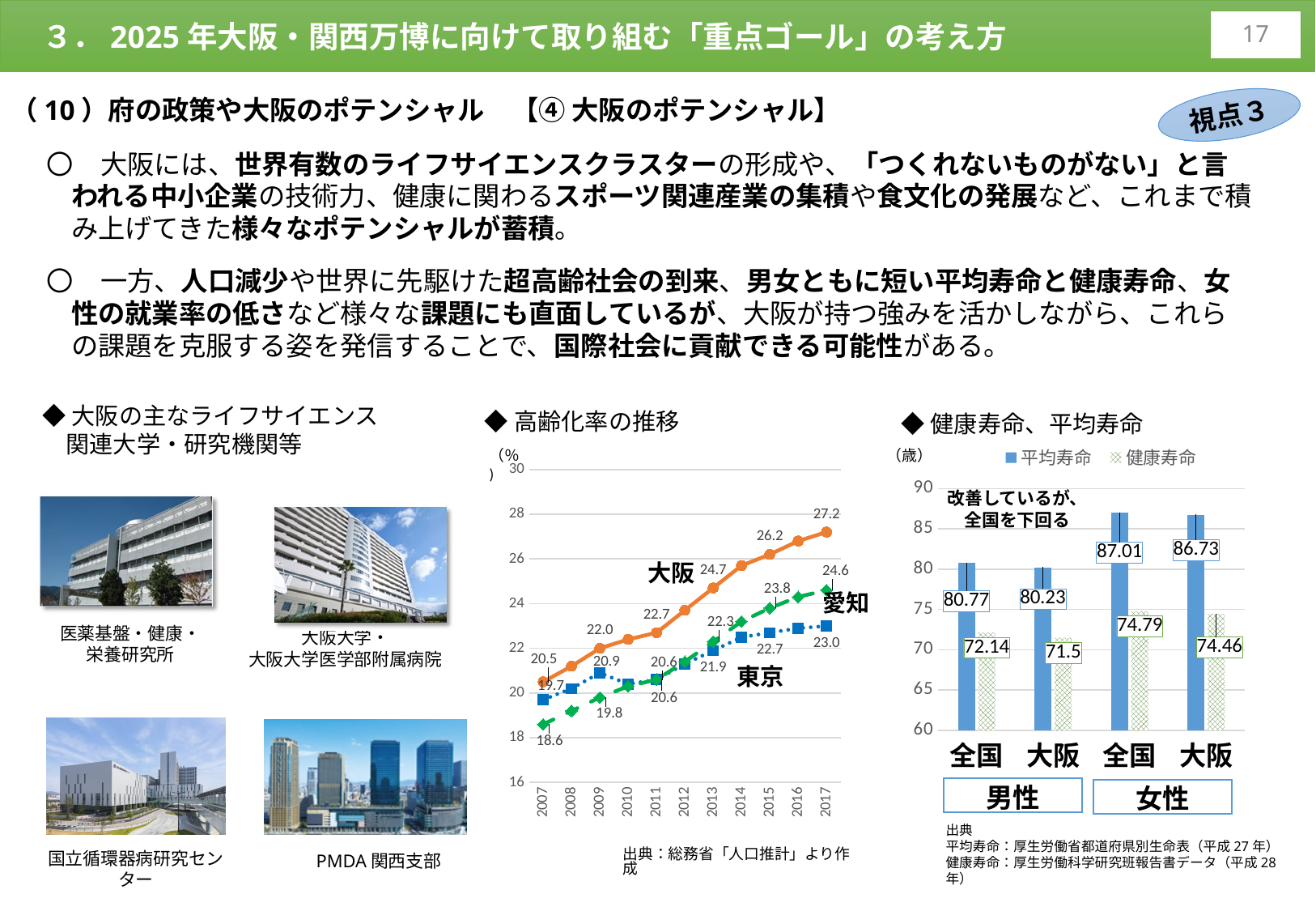
In the 高齢化率の推移 chart, what is the value for 東京 in 2017? 23.0 In the 高齢化率の推移 chart, what is the value for 愛知 in 2007? 18.6 In the 健康寿命、平均寿命 chart, is the 平均寿命 for 全国 women (女性) greater or less than the 平均寿命 for 大阪 women (女性)? greater In the 健康寿命、平均寿命 chart, what is the 健康寿命 value for 全国 women (女性)? 74.79 What kind of chart is the 高齢化率の推移 chart? line chart In the 高齢化率の推移 chart, does the value for 大阪 rise or fall from 2007 to 2017? rise In the 高齢化率の推移 chart, what is the difference between 大阪 and 東京 in 2017? 4.2 In the 健康寿命、平均寿命 chart, how many series does the legend list? 2 In the 高齢化率の推移 chart, what is the value for 大阪 in 2017? 27.2 In the 健康寿命、平均寿命 chart, which category has the lowest 健康寿命 value? 大阪 (男性) In the 高齢化率の推移 chart, which series has the highest value in 2017? 大阪 In the 健康寿命、平均寿命 chart, what is the 平均寿命 value for 大阪 men (男性)? 80.23